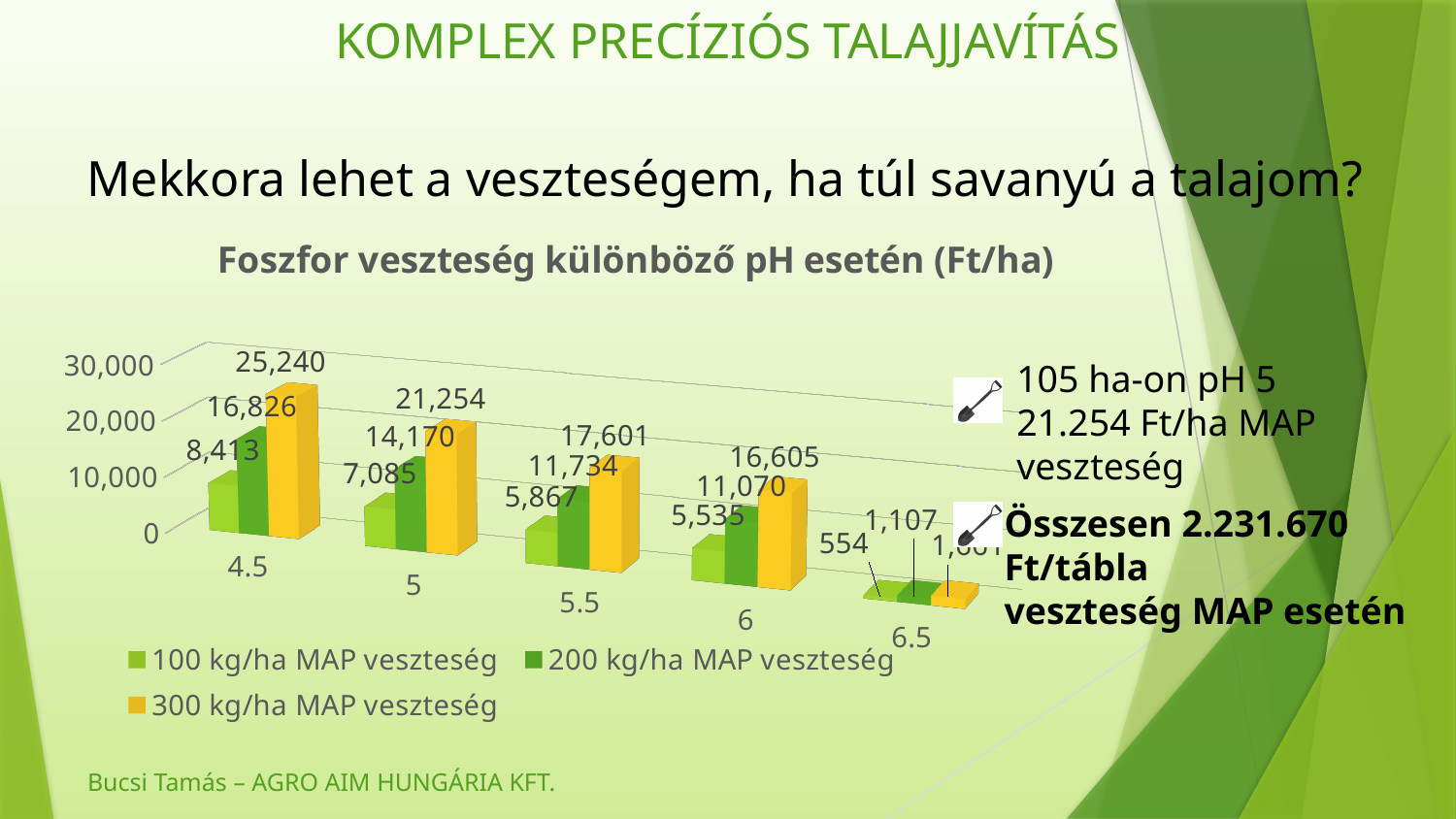
How many pH categories are shown on the x axis of the chart? 5 What kind of chart is shown on the slide? Bar chart How many series does the chart legend list? 3 What is the value of the 100 kg/ha MAP veszteség series at pH 5? 7,085 At which pH category is the 300 kg/ha MAP veszteség value highest? 4.5 Which is larger: the 200 kg/ha MAP veszteség value at pH 6 or the 100 kg/ha MAP veszteség value at pH 4.5? 200 kg/ha MAP veszteség at pH 6 What is the title of the chart? Foszfor veszteség különböző pH esetén (Ft/ha) What is the value of the 200 kg/ha MAP veszteség series at pH 5.5? 11,734 At which pH category is the 100 kg/ha MAP veszteség value lowest? 6.5 Do the 300 kg/ha MAP veszteség values rise or fall as pH increases along the x axis? Fall What is the difference between the 300 kg/ha MAP veszteség values at pH 4.5 and pH 5? 3,986 What is the value of the 300 kg/ha MAP veszteség series at pH 4.5? 25,240